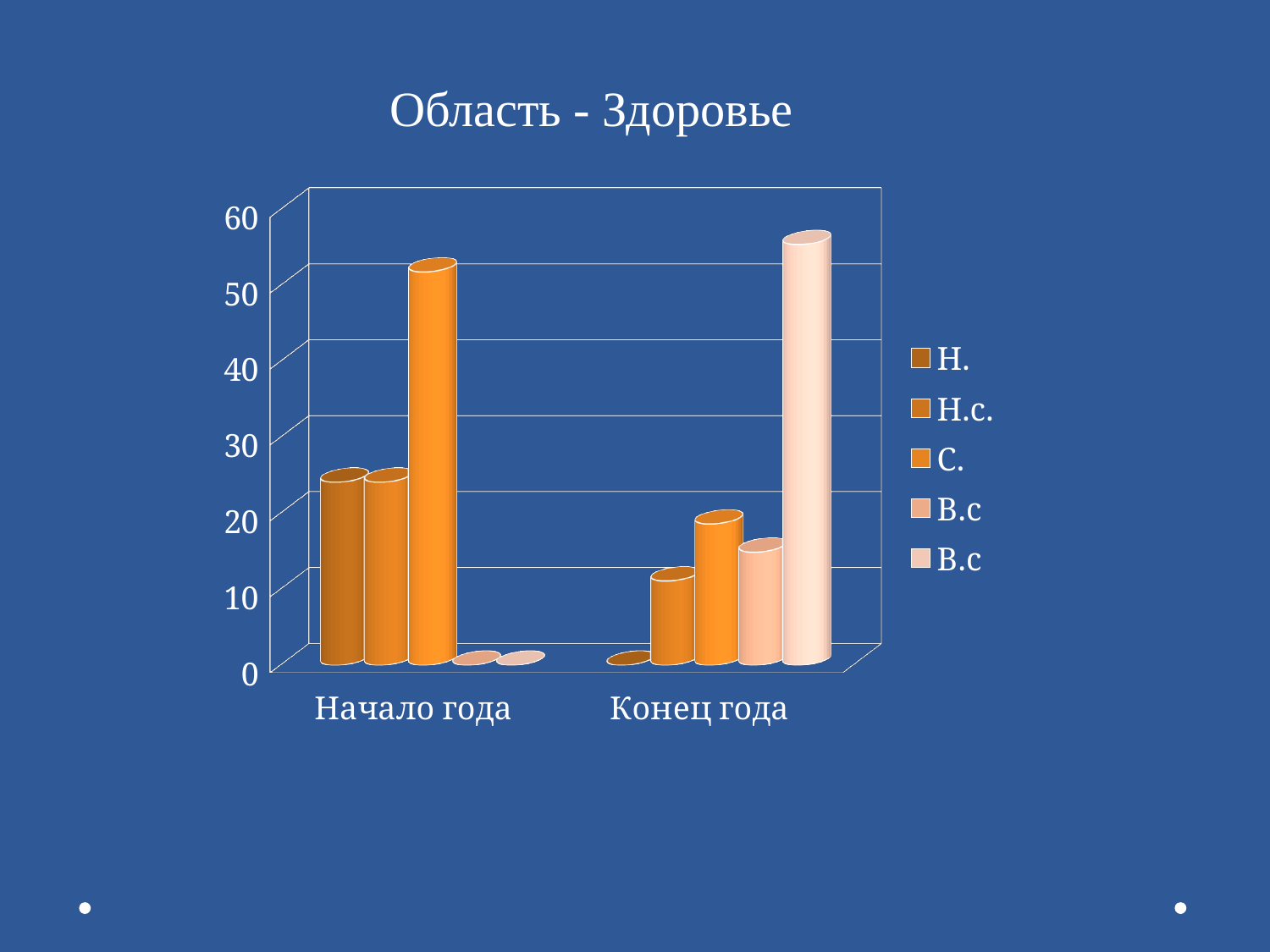
What is the title of the chart? Область - Здоровье How many series does the legend list? 5 What kind of chart is shown on the slide? bar chart Does the value for Н. rise or fall from Начало года to Конец года? fall Which is larger in Начало года: the value for С. or the value for Н.? С. Which series has the highest value in the Начало года category? С. How many categories are shown on the x axis? 2 Is the tallest bar in the Конец года category greater or less than 50? greater Is the value for С. in Начало года greater or less than 40? greater Is the value for Н. in Начало года greater or less than 10? greater Which is larger in Конец года: the value for С. or the value for Н.с.? С.